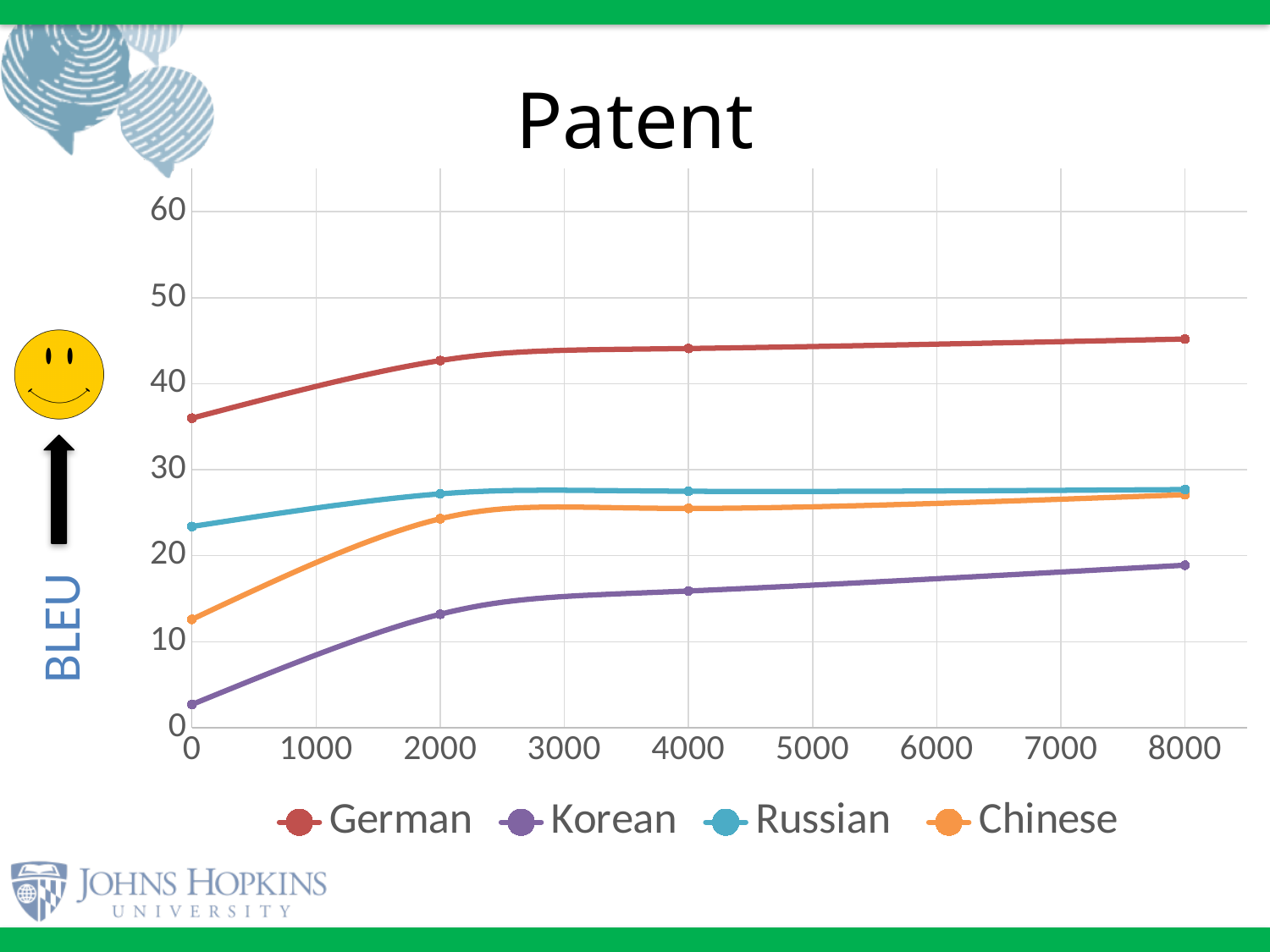
Is the BLEU value for Korean at 0 greater or less than 10? less Does the Korean series rise or fall as the x axis increases from 0 to 8000? rise Which series has the lowest BLEU score at 0? Korean What is the label on the y axis? BLEU What is the title of the chart? Patent How many series does the legend list? 4 What kind of chart is shown on the slide? line chart Is the BLEU value for Korean at 8000 greater or less than 20? less Is the BLEU value for German at 0 greater or less than 30? greater At 0 on the x axis, which series has the larger BLEU score, Russian or Chinese? Russian Which series has the highest BLEU score at 8000? German